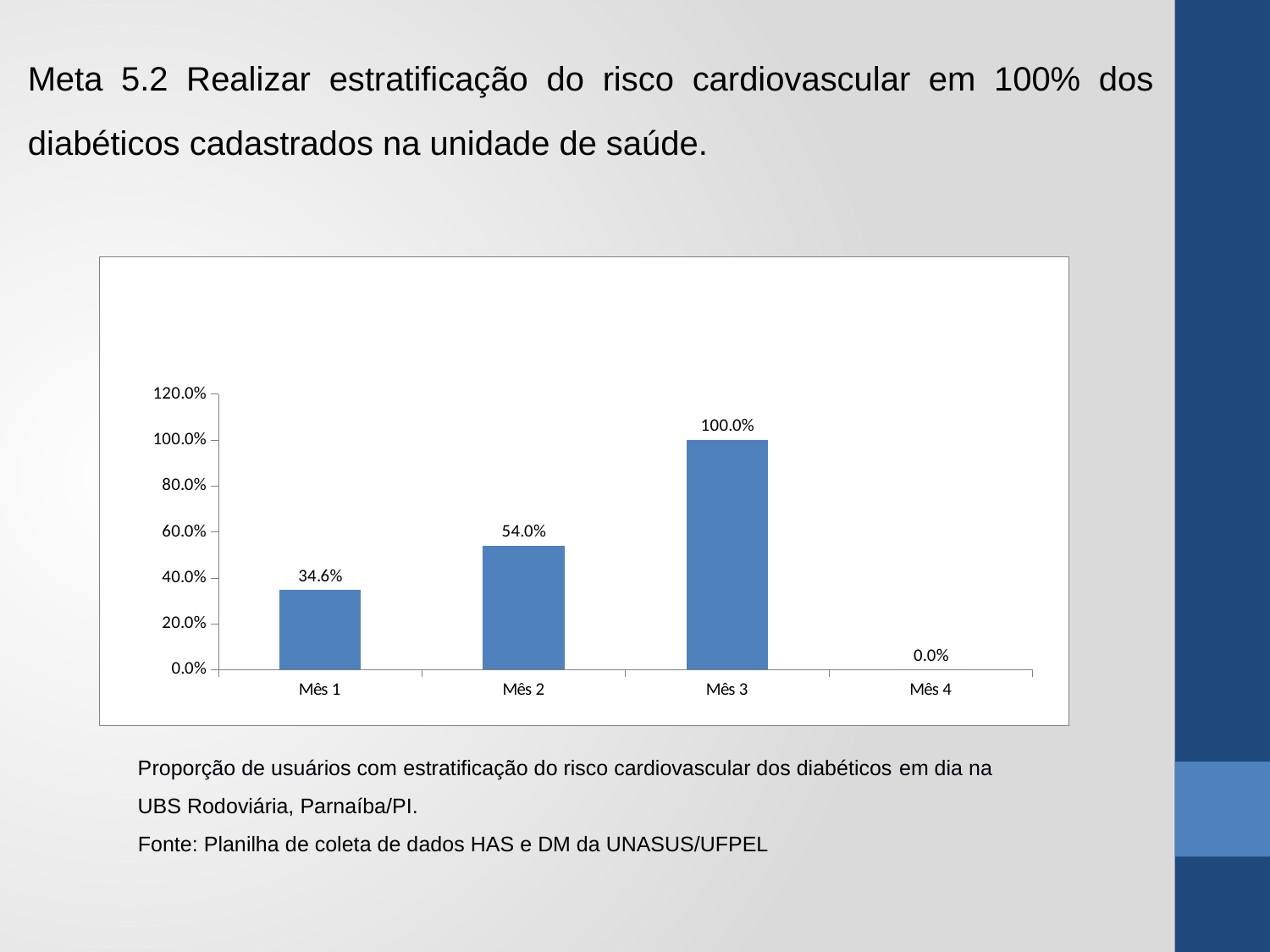
Which month has the highest value? Mês 3 What is the value for Mês 3? 100.0% What is the difference between the values for Mês 3 and Mês 2? 46.0% What kind of chart is shown on the slide? Bar chart Which is larger, the value for Mês 1 or the value for Mês 2? Mês 2 What is the value for Mês 2? 54.0% How many months are shown on the x axis? 4 What is the value for Mês 1? 34.6% Do the values rise or fall from Mês 1 to Mês 3? Rise Which month has the lowest value? Mês 4 What is the difference between the values for Mês 2 and Mês 1? 19.4% What is the value for Mês 4? 0.0%